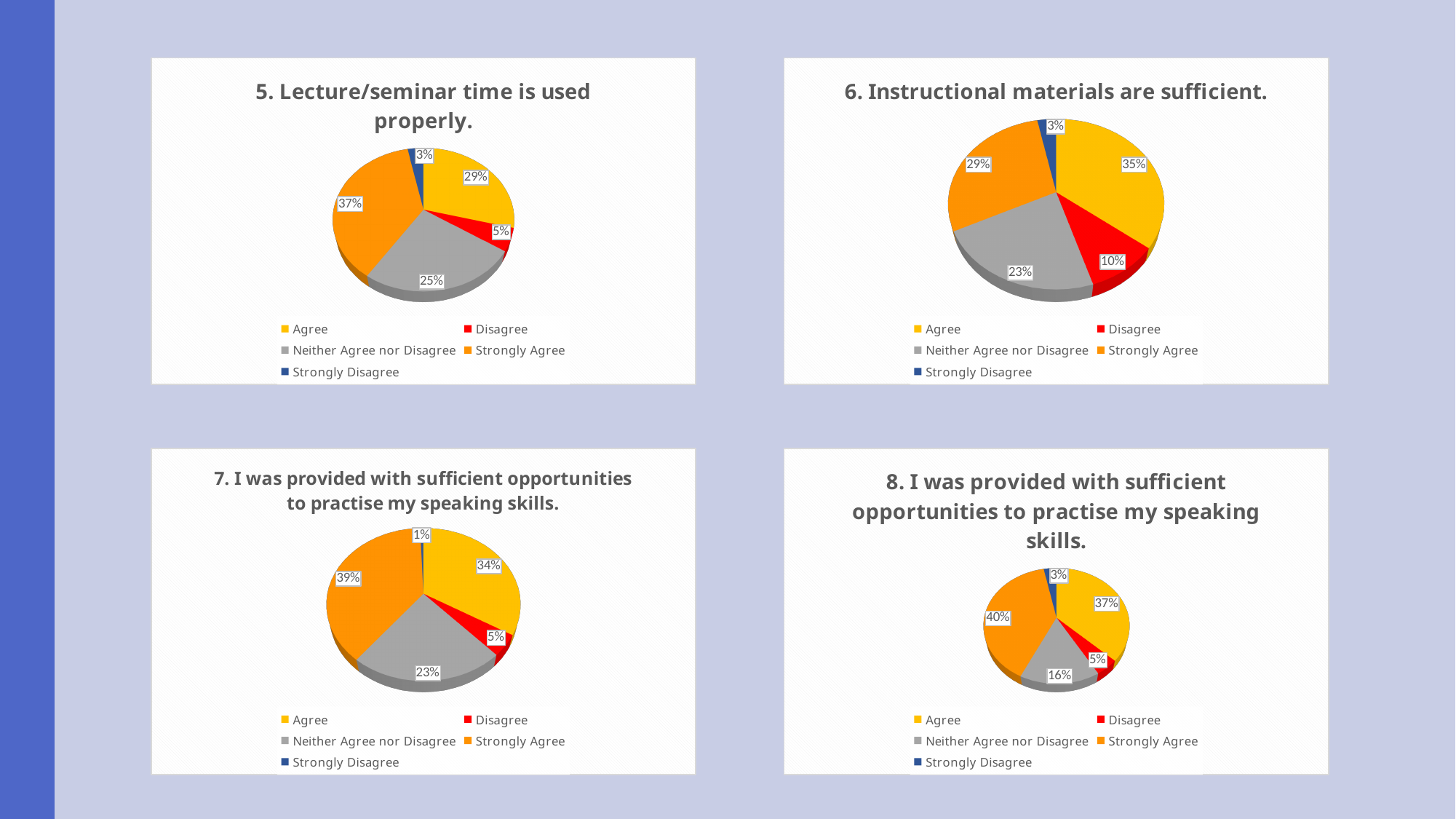
In the chart titled "5. Lecture/seminar time is used properly.", which response category has the smallest slice? Strongly Disagree How many response categories does the legend of the chart titled "5. Lecture/seminar time is used properly." list? 5 In the chart titled "7. I was provided with sufficient opportunities to practise my speaking skills.", which colour represents Neither Agree nor Disagree? Grey In the chart titled "8. I was provided with sufficient opportunities to practise my speaking skills.", what share of responses is Neither Agree nor Disagree? 16% In the chart titled "7. I was provided with sufficient opportunities to practise my speaking skills.", which is larger, Agree or Strongly Agree? Strongly Agree In the chart titled "6. Instructional materials are sufficient.", which response category has the largest slice? Agree In the chart titled "8. I was provided with sufficient opportunities to practise my speaking skills.", what is the combined share of Agree and Strongly Agree? 77% What kind of chart is used in the top-left chart on the slide? Pie chart In the chart titled "7. I was provided with sufficient opportunities to practise my speaking skills.", what share of responses is Strongly Disagree? 1% In the chart titled "6. Instructional materials are sufficient.", what is the difference between the Agree and Strongly Agree shares? 6% In the chart titled "5. Lecture/seminar time is used properly.", what share of responses is Strongly Agree? 37% In the chart titled "6. Instructional materials are sufficient.", what share of responses is Disagree? 10%